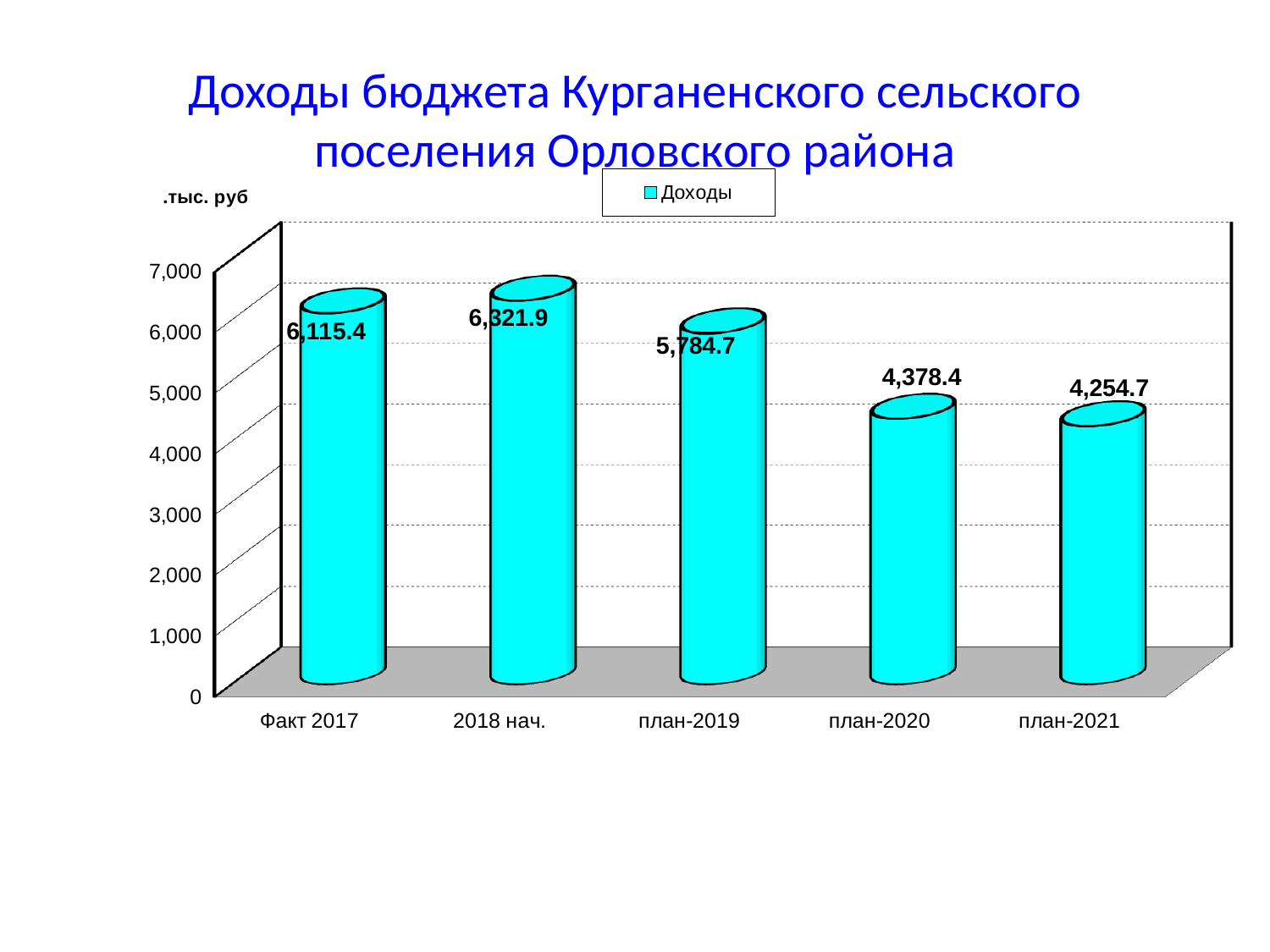
Which category has the highest value? 2018 нач. How many categories are shown on the x axis? 5 Is the value for план-2019 greater or less than 5,000? greater What is the difference between the values for план-2019 and план-2020? 1,406.3 Which category has the lowest value? план-2021 What is the value for Факт 2017? 6,115.4 What is the value for план-2020? 4,378.4 What kind of chart is shown on the slide? bar chart What is the difference between the values for 2018 нач. and Факт 2017? 206.5 Which is larger, the value for план-2019 or the value for план-2020? план-2019 Do the values rise or fall from план-2019 to план-2021? fall What is the value for план-2021? 4,254.7